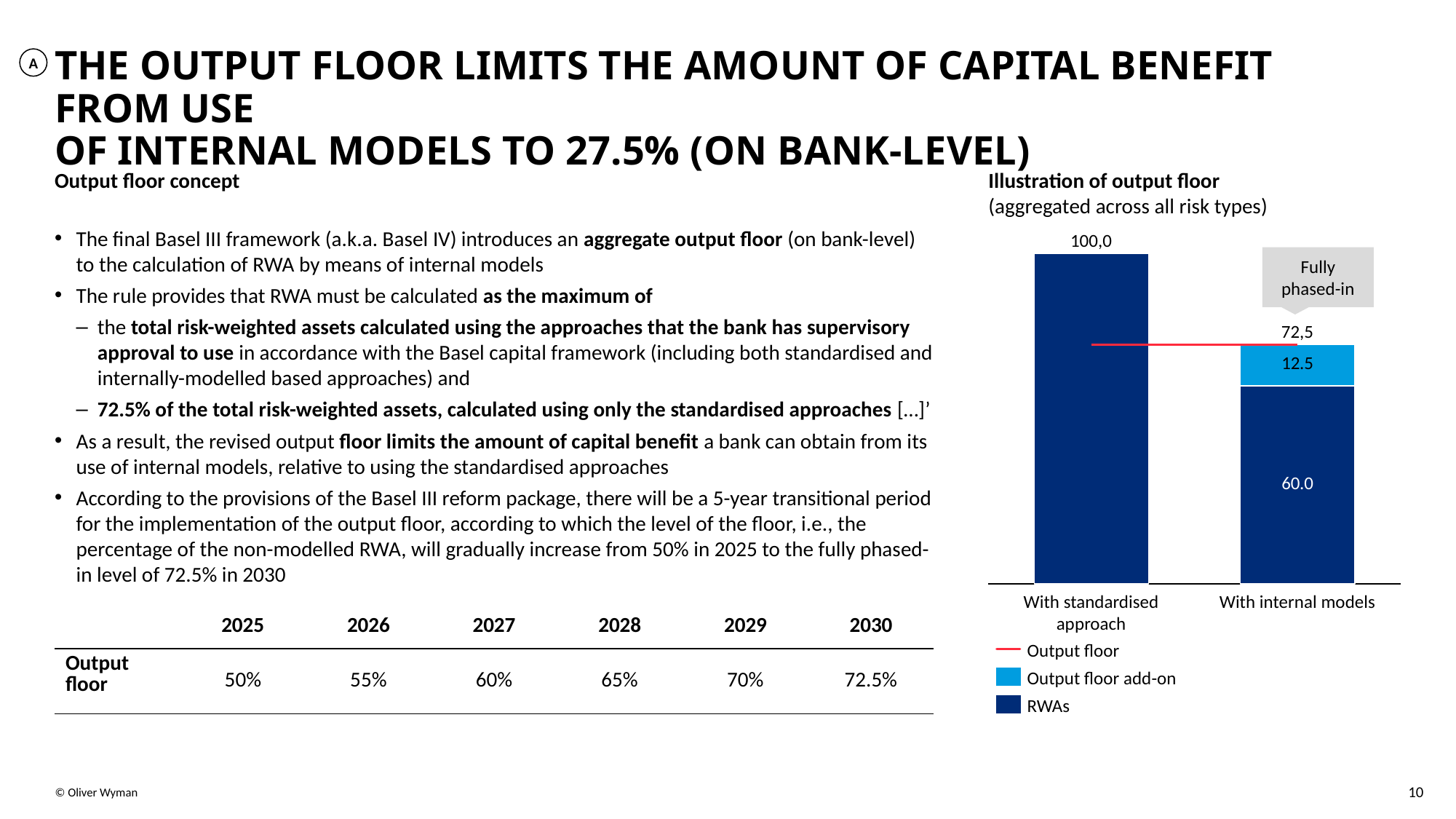
Which bar is taller, 'With standardised approach' or 'With internal models'? With standardised approach Which category has the lowest total value in the chart? With internal models What is the total shown above the 'With internal models' bar? 72,5 What is the difference between the 'With standardised approach' total (100,0) and the 'With internal models' total (72,5)? 27,5 How many entries does the chart legend list? 3 Which legend entry is represented by the red line in the chart? Output floor What does the callout box above the 'With internal models' bar say? Fully phased-in How many bars are plotted in the chart? 2 What is the RWAs value shown for the 'With internal models' bar? 60.0 What is the value shown for the 'With standardised approach' bar? 100,0 What kind of chart is shown on the slide? Stacked bar chart What is the output floor add-on value shown for the 'With internal models' bar? 12.5